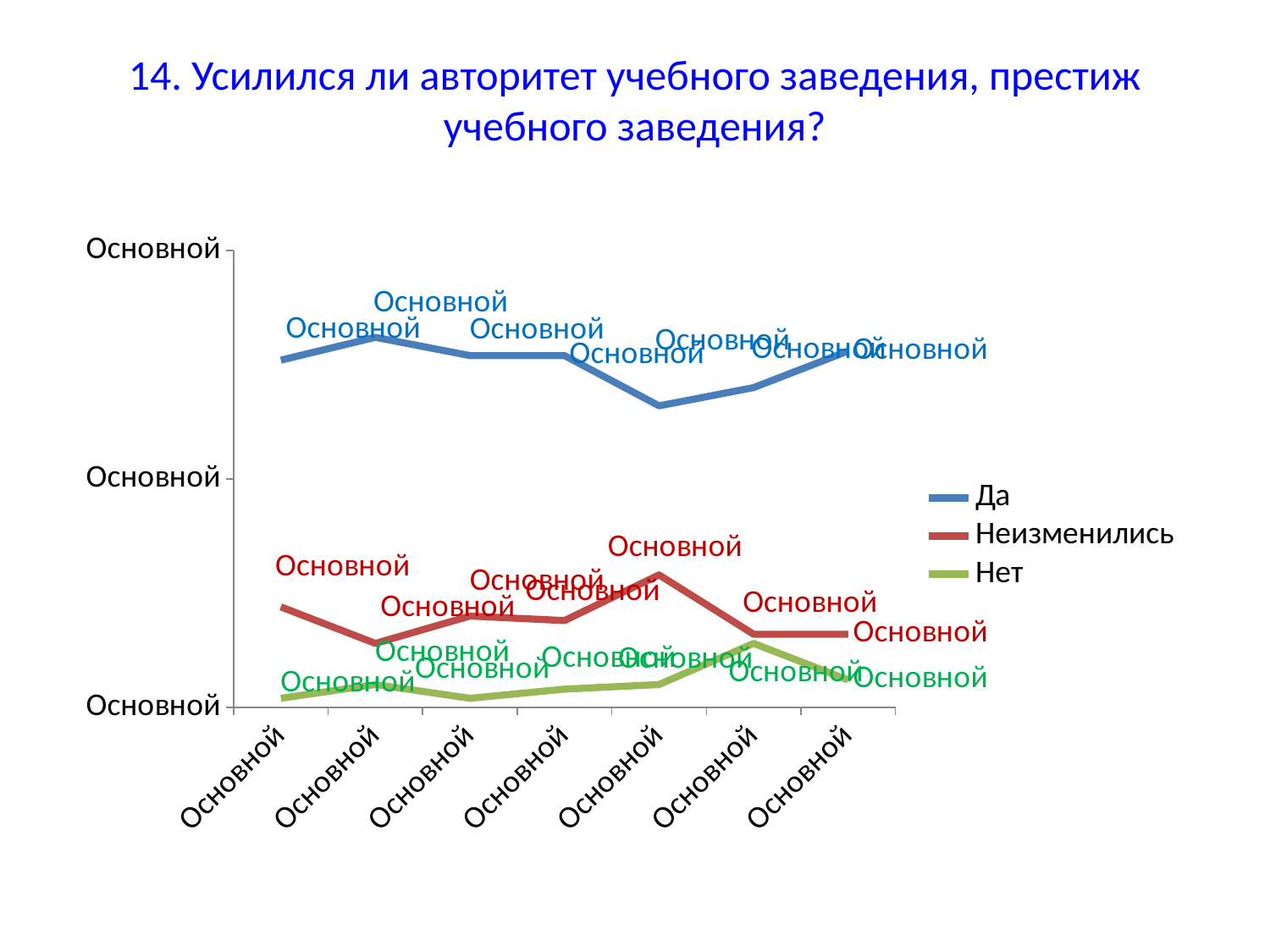
At the first point on the x axis, which is larger: the value for "Да" or the value for "Неизменились"? Да Which series has the lowest values across the whole chart? Нет What are the series names listed in the legend? Да, Неизменились, Нет Which series has the highest values across the whole chart? Да At the last point on the x axis, which is larger: the value for "Неизменились" or the value for "Нет"? Неизменились At which point along the x axis (counting from the left) does the "Да" line reach its lowest value? 5th How many series does the legend list? 3 At which point along the x axis (counting from the left) does the "Нет" line reach its highest value? 6th Which colour is used for the series "Да"? Blue What kind of chart is shown on the slide? Line chart How many data points does each line have? 7 At which point along the x axis (counting from the left) does the "Неизменились" line reach its highest value? 5th